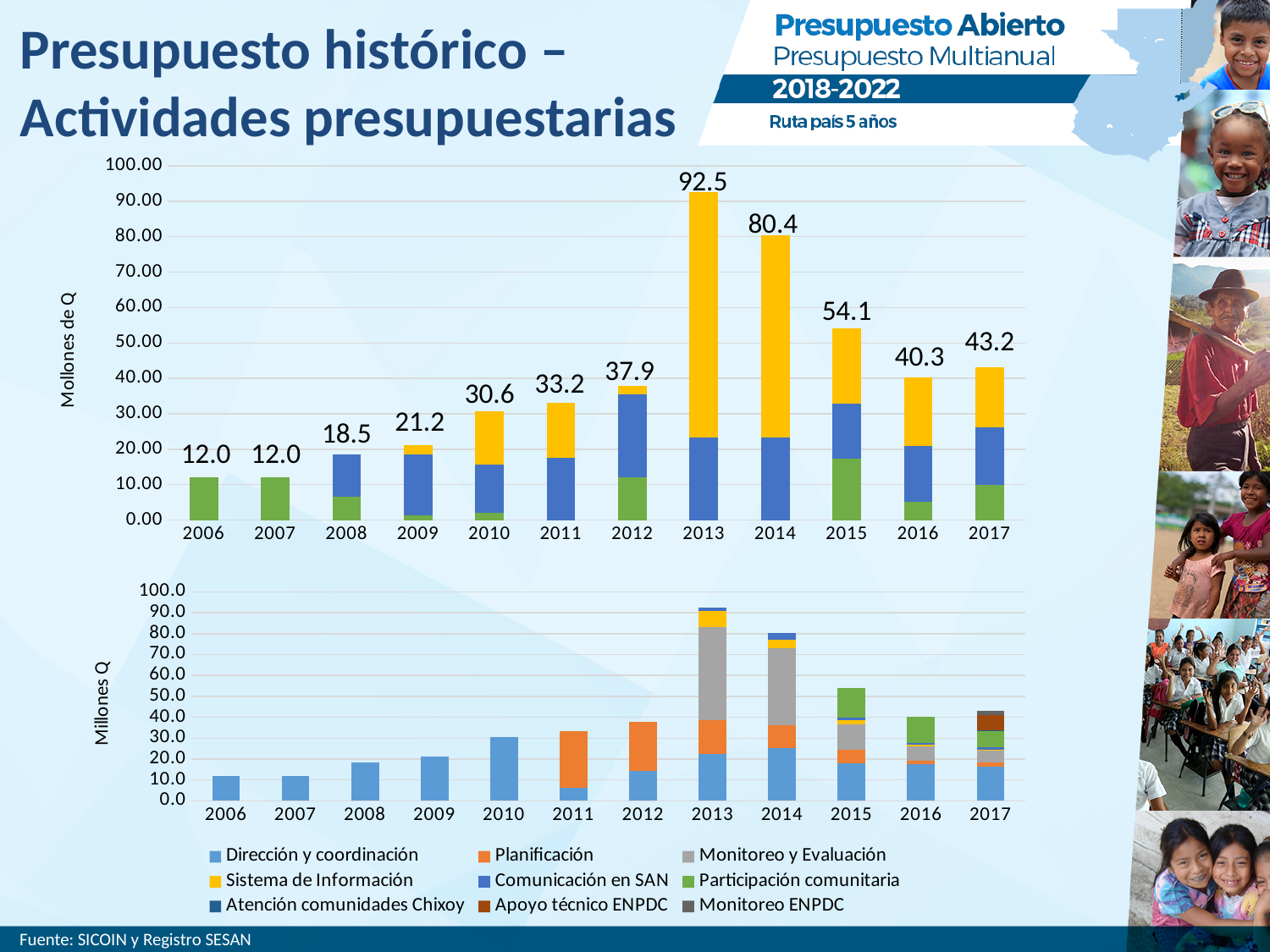
How many series does the legend of the bottom chart list? 9 In the top chart, which year has the larger total, 2016 or 2017? 2017 In the top chart, do the totals rise or fall from 2006 to 2013? Rise In the top chart, what is the difference between the totals for 2017 and 2016? 2.9 What kind of chart is the top chart? Stacked bar chart How many years are shown on the x axis of the top chart? 12 In the top chart, what is the difference between the totals for 2013 and 2014? 12.1 In the top chart, what is the total value shown for 2010? 30.6 In the top chart, which year has the highest total value? 2013 What is the y-axis label of the bottom chart? Millones de Q In the top chart, what is the total value shown for 2013? 92.5 In the bottom chart, is the total value for 2013 greater or less than 80? greater